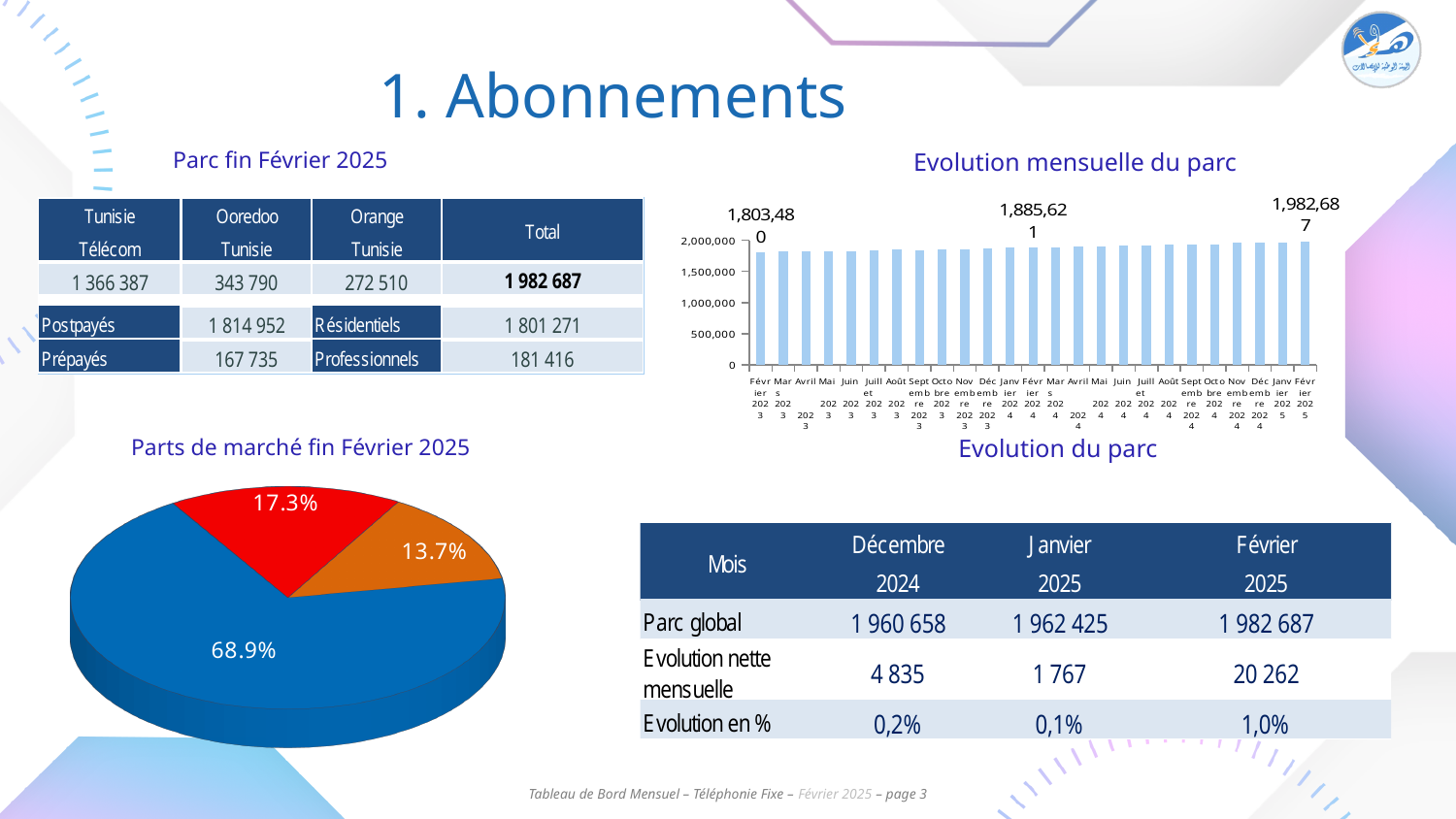
In the 'Evolution mensuelle du parc' bar chart, which month has the highest bar? Février 2025 What kind of chart is the 'Evolution mensuelle du parc' chart? bar chart In the 'Parts de marché fin Février 2025' pie chart, how many slices are there? 3 In the 'Evolution mensuelle du parc' bar chart, is the value for Février 2025 greater or less than 1,500,000? greater In the 'Parts de marché fin Février 2025' pie chart, what share does the smallest (orange) slice have? 13.7% In the 'Evolution mensuelle du parc' bar chart, do the values generally rise or fall from Février 2023 to Février 2025? rise In the 'Parts de marché fin Février 2025' pie chart, what share does the largest (blue) slice have? 68.9% In the 'Evolution mensuelle du parc' bar chart, is the value for Février 2023 greater or less than 2,000,000? less What kind of chart is the 'Parts de marché fin Février 2025' chart? pie chart In the 'Parts de marché fin Février 2025' pie chart, which slice is larger, the red one or the orange one? the red one In the 'Parts de marché fin Février 2025' pie chart, what share does the red slice have? 17.3% In the 'Parts de marché fin Février 2025' pie chart, what is the difference in percentage points between the red slice (17.3%) and the orange slice (13.7%)? 3.6